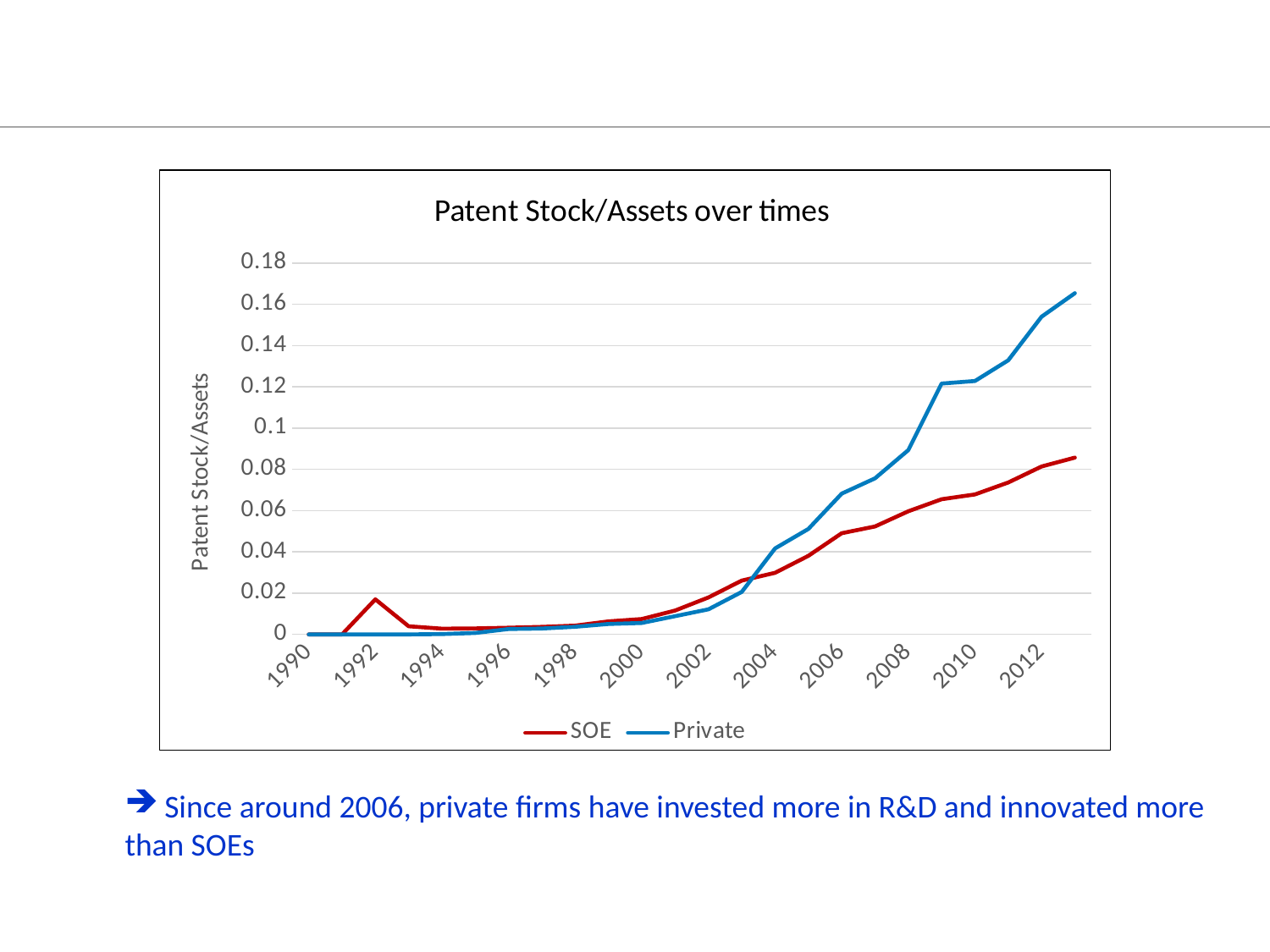
What kind of chart is shown on the slide? Line chart Is the SOE value in 2012 greater or less than 0.1? less Is the Private value in 2012 greater or less than 0.14? greater What is the title of the chart? Patent Stock/Assets over times Is the SOE value in 2006 greater or less than 0.06? less In 2012, which series has the higher Patent Stock/Assets value, SOE or Private? Private In 1992, which series has the higher Patent Stock/Assets value, SOE or Private? SOE Which series is drawn in blue? Private How many series does the legend list? 2 Which series reaches the highest value on the chart? Private Does the Private series generally rise or fall from 2000 to 2012? Rise